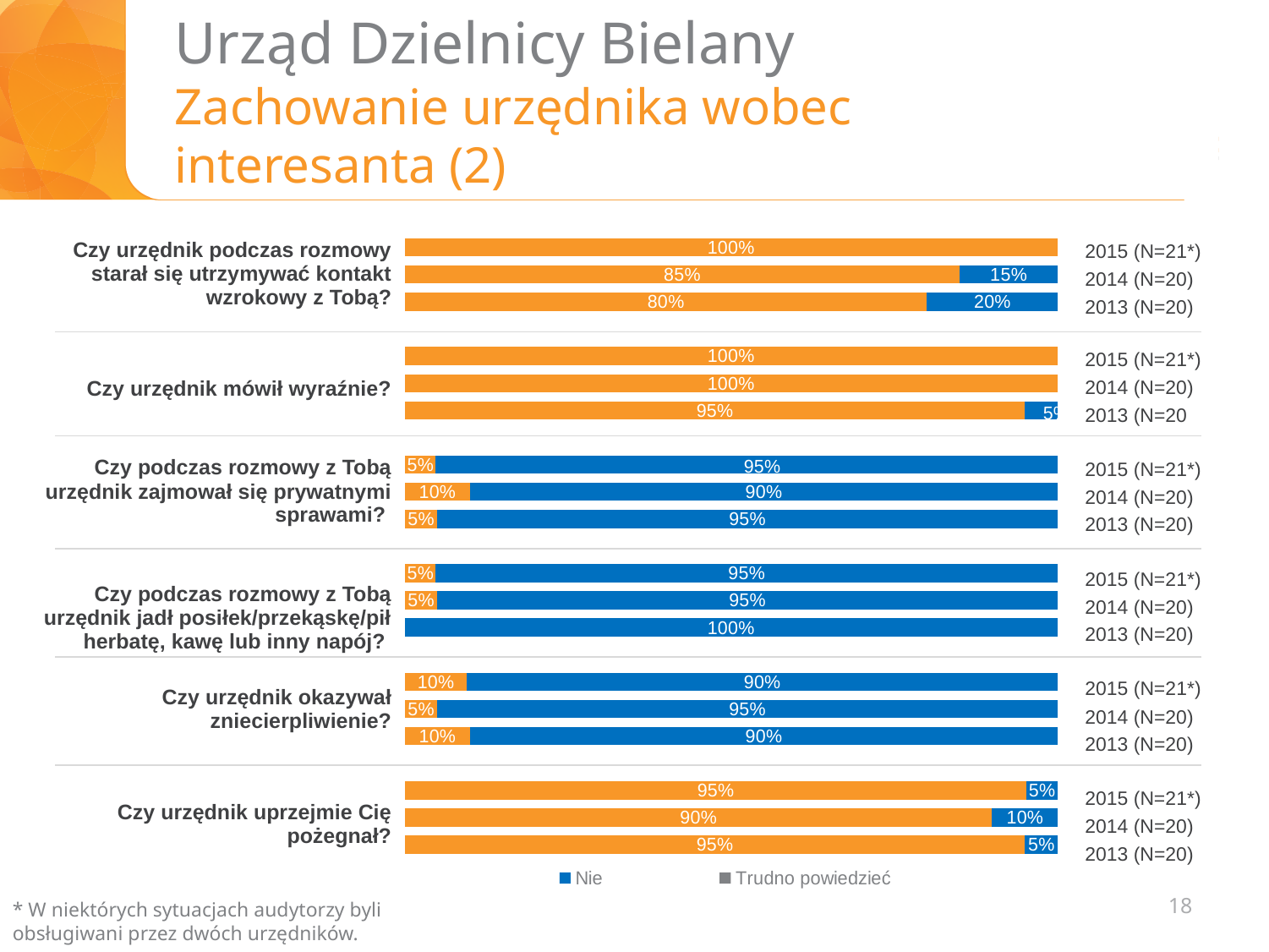
What kind of chart is shown on the slide? Stacked bar chart For the question "Czy urzędnik mówił wyraźnie?", what is the value of the orange segment for 2013? 95% For the question "Czy urzędnik podczas rozmowy starał się utrzymywać kontakt wzrokowy z Tobą?", what is the total of the 2014 bar? 100% For the question "Czy urzędnik uprzejmie Cię pożegnał?", which year has the highest "Nie" value? 2014 For the question "Czy urzędnik okazywał zniecierpliwienie?", what is the "Nie" value for 2015? 90% Which colour represents "Nie" in the chart legend? Blue For the question "Czy podczas rozmowy z Tobą urzędnik zajmował się prywatnymi sprawami?", which year has the larger "Nie" value, 2014 or 2015? 2015 For the question "Czy urzędnik uprzejmie Cię pożegnał?", what is the "Nie" value for 2014? 10% For the question "Czy urzędnik podczas rozmowy starał się utrzymywać kontakt wzrokowy z Tobą?", what is the "Nie" value for 2013? 20% For the question "Czy urzędnik podczas rozmowy starał się utrzymywać kontakt wzrokowy z Tobą?", what is the difference between the orange segment values for 2014 and 2013? 5 percentage points For the question "Czy urzędnik podczas rozmowy starał się utrzymywać kontakt wzrokowy z Tobą?", does the orange segment value rise or fall from 2013 to 2015? Rises How many years are shown for each question in the chart? 3